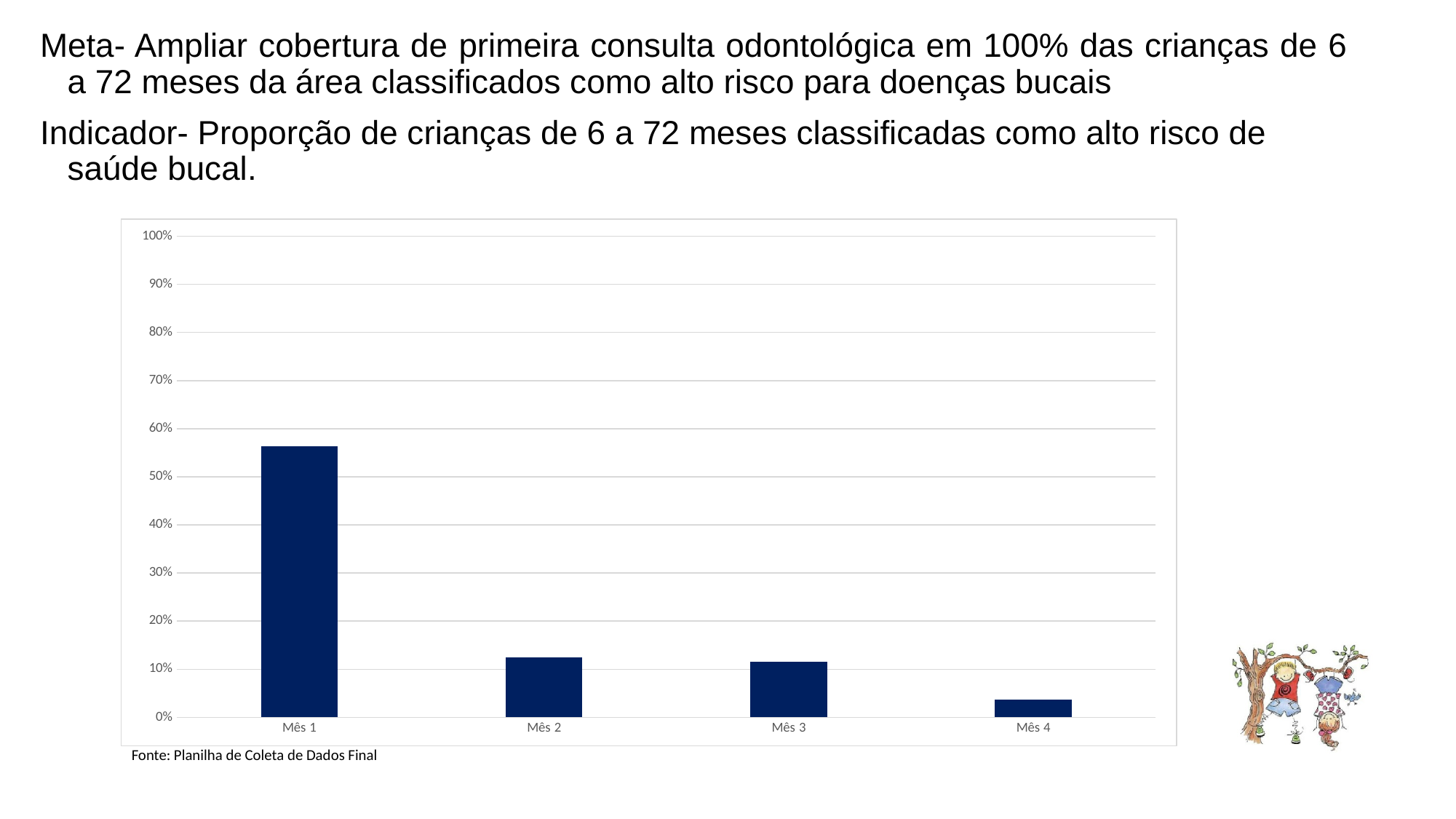
Which month has the highest value in the chart? Mês 1 Which is larger, the value for Mês 1 or the value for Mês 2? Mês 1 What kind of chart is shown on the slide? bar chart Is the value for Mês 4 greater or less than 10%? less Which month has the lowest value in the chart? Mês 4 How many categories (months) are plotted on the x axis of the chart? 4 Is the value for Mês 2 greater or less than 10%? greater Is the value for Mês 1 greater or less than 60%? less What source is cited below the chart? Planilha de Coleta de Dados Final Do the values generally rise or fall from Mês 1 to Mês 4? fall